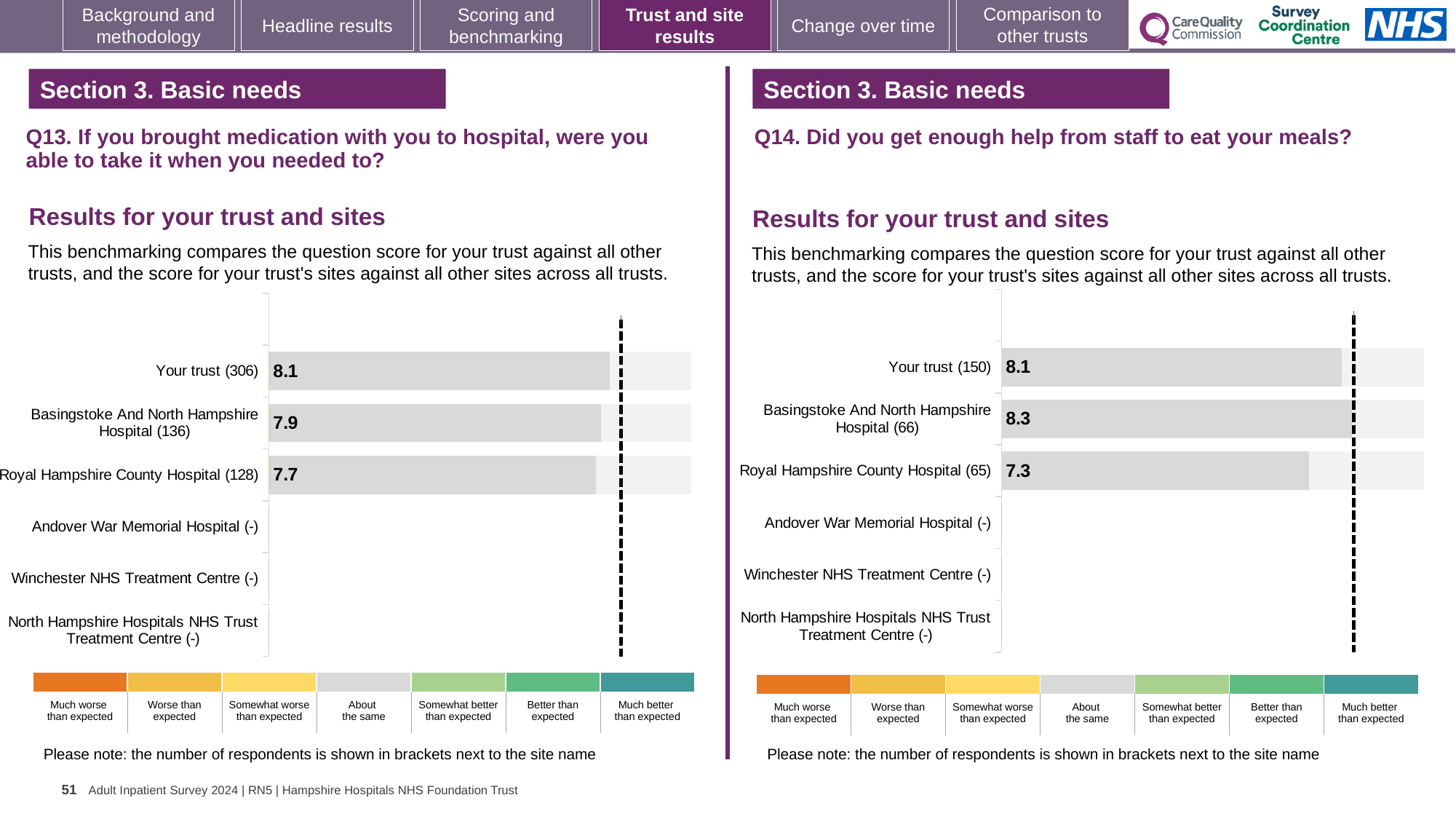
What kind of chart is used for the Q14 results? Bar chart On the Q14 chart, what is the score for Basingstoke And North Hampshire Hospital (66)? 8.3 On the Q13 chart, which site or trust row has the lowest plotted score? Royal Hampshire County Hospital (128) On the Q13 chart, what is the score for Basingstoke And North Hampshire Hospital (136)? 7.9 On the Q14 chart, what is the score for Royal Hampshire County Hospital (65)? 7.3 On the Q13 chart, what is the score for Your trust (306)? 8.1 On the Q14 chart, which is larger: the score for Your trust or the score for Royal Hampshire County Hospital? Your trust On the Q13 chart, what is the difference between the scores for Your trust and Royal Hampshire County Hospital? 0.4 On the Q14 chart, what is the difference between the scores for Basingstoke And North Hampshire Hospital and Royal Hampshire County Hospital? 1.0 On the Q14 chart, which site or trust row has the highest score? Basingstoke And North Hampshire Hospital (66) On the Q13 chart, what is the score for Royal Hampshire County Hospital (128)? 7.7 How many site or trust rows are listed on the Q13 chart? 6